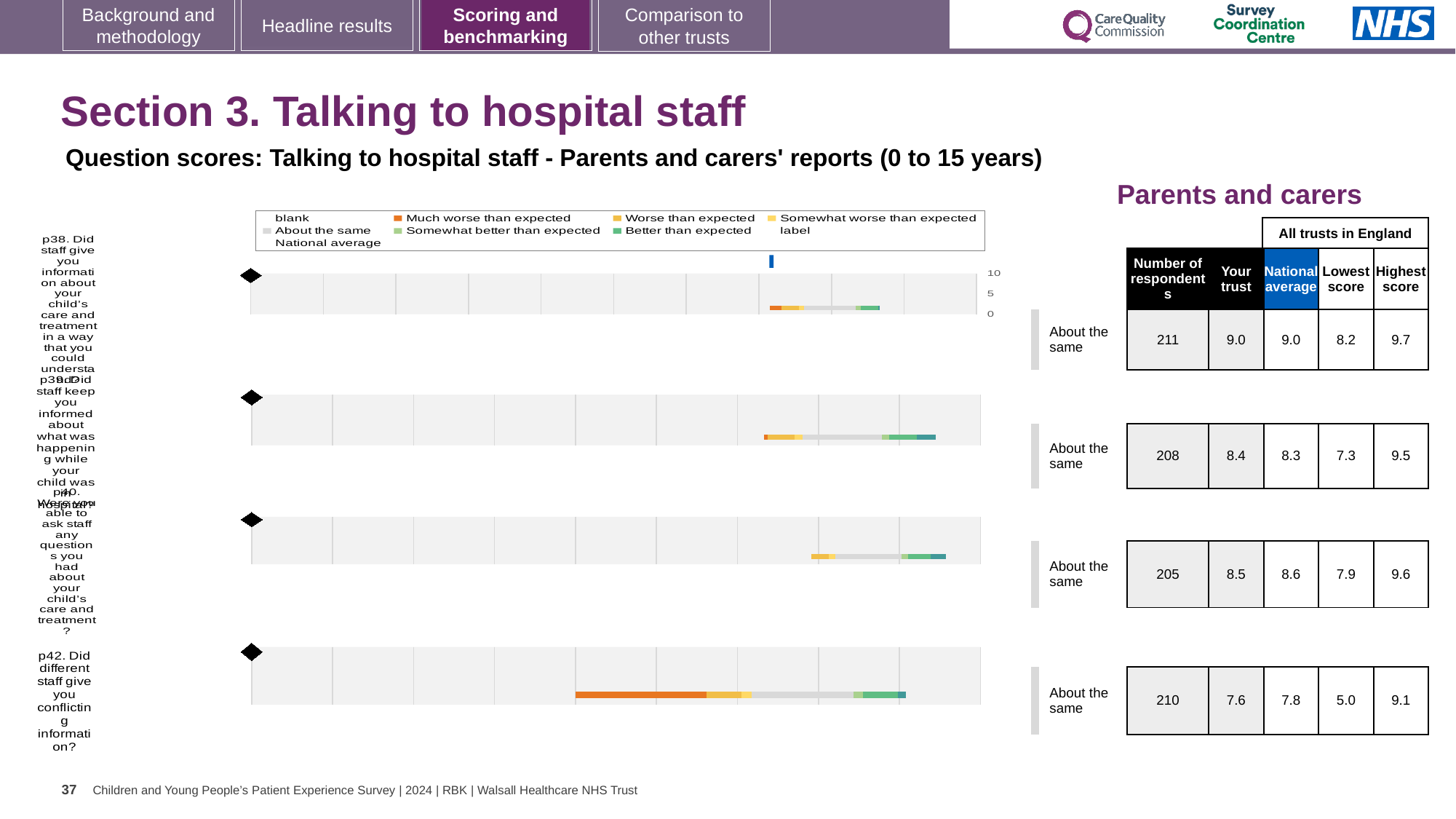
For question p42, what is the difference between the highest score and the lowest score in the table beside the chart? 4.1 Which question has the lowest 'Your trust' score in the table beside the chart? p42 In the table beside the chart, what is the lowest score across all trusts in England for question p42? 5.0 What benchmark label is shown next to the bar for question p42? About the same Which question has the highest 'Your trust' score in the table beside the chart? p38 In the table beside the chart, what is the 'Your trust' score for question p38? 9.0 In the table beside the chart, what is the national average for question p40? 8.6 In the table beside the chart, what is the highest score across all trusts in England for question p39? 9.5 In the table beside the chart, how many respondents are listed for question p42? 210 In the chart legend, which entry is shown in orange? Much worse than expected What kind of chart is used to show the question scores on this slide? bar chart How many survey questions (bars) are plotted in the chart? 4